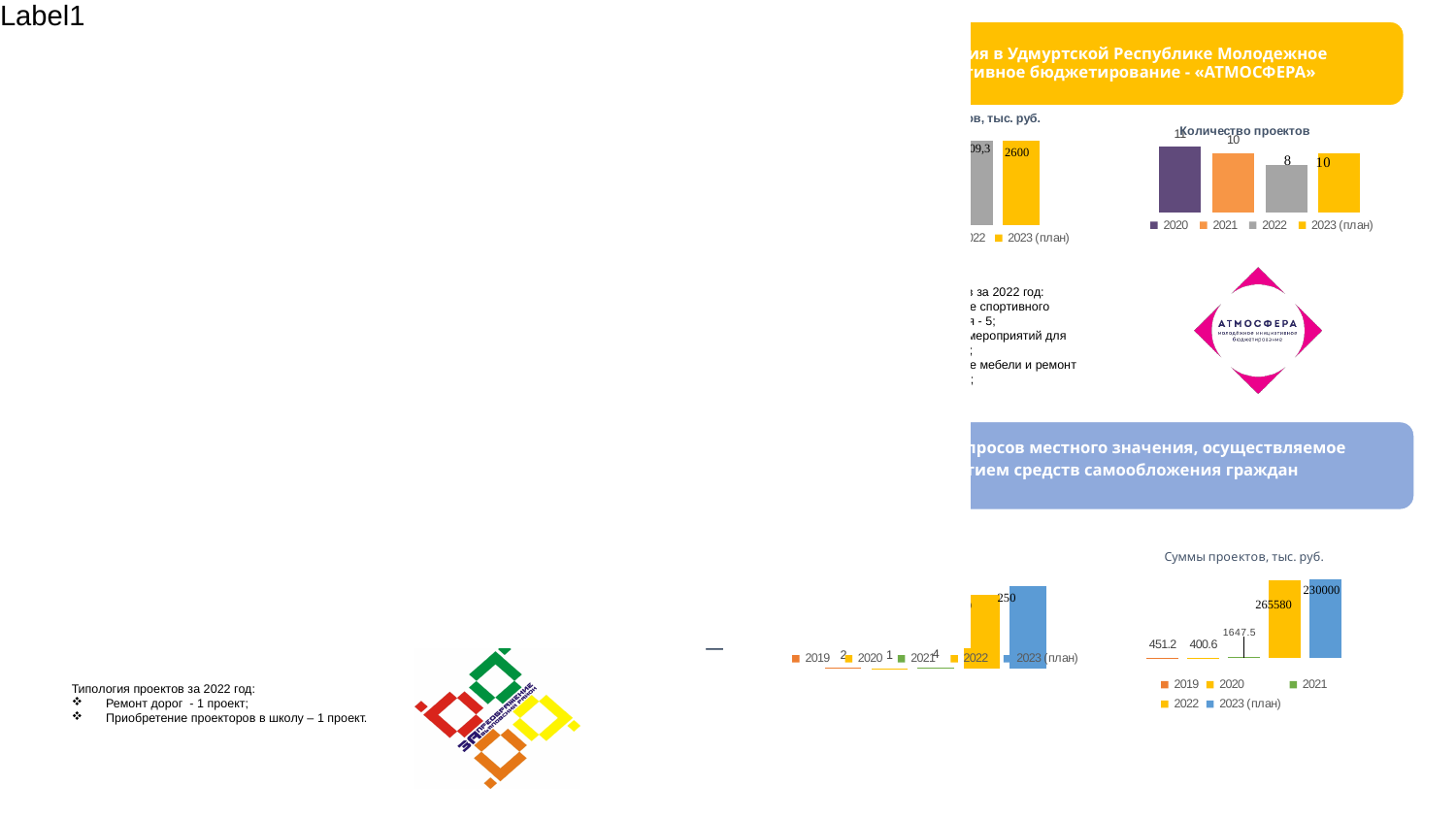
In the 'Количество проектов' chart, which year has the highest value? 2020 In the 'Количество проектов' chart, which year has the lowest value? 2022 In the 'Суммы проектов, тыс. руб.' chart, what is the value for 2023 (план)? 230000 In the 'Количество проектов' chart, what is the value for 2022? 8 How many entries does the legend of the 'Количество проектов' chart list? 4 In the 'Суммы проектов, тыс. руб.' chart, which is larger, the value for 2019 or the value for 2020? 2019 In the 'Количество проектов' chart, what is the value for 2023 (план)? 10 In the 'Суммы проектов, тыс. руб.' chart, what is the value for 2019? 451.2 What kind of chart is the 'Суммы проектов, тыс. руб.' chart at the bottom right? bar chart In the 'Количество проектов' chart, what is the value for 2021? 10 In the 'Суммы проектов, тыс. руб.' chart, what is the value for 2021? 1647.5 In the 'Количество проектов' chart, what is the difference between the values for 2021 and 2022? 2